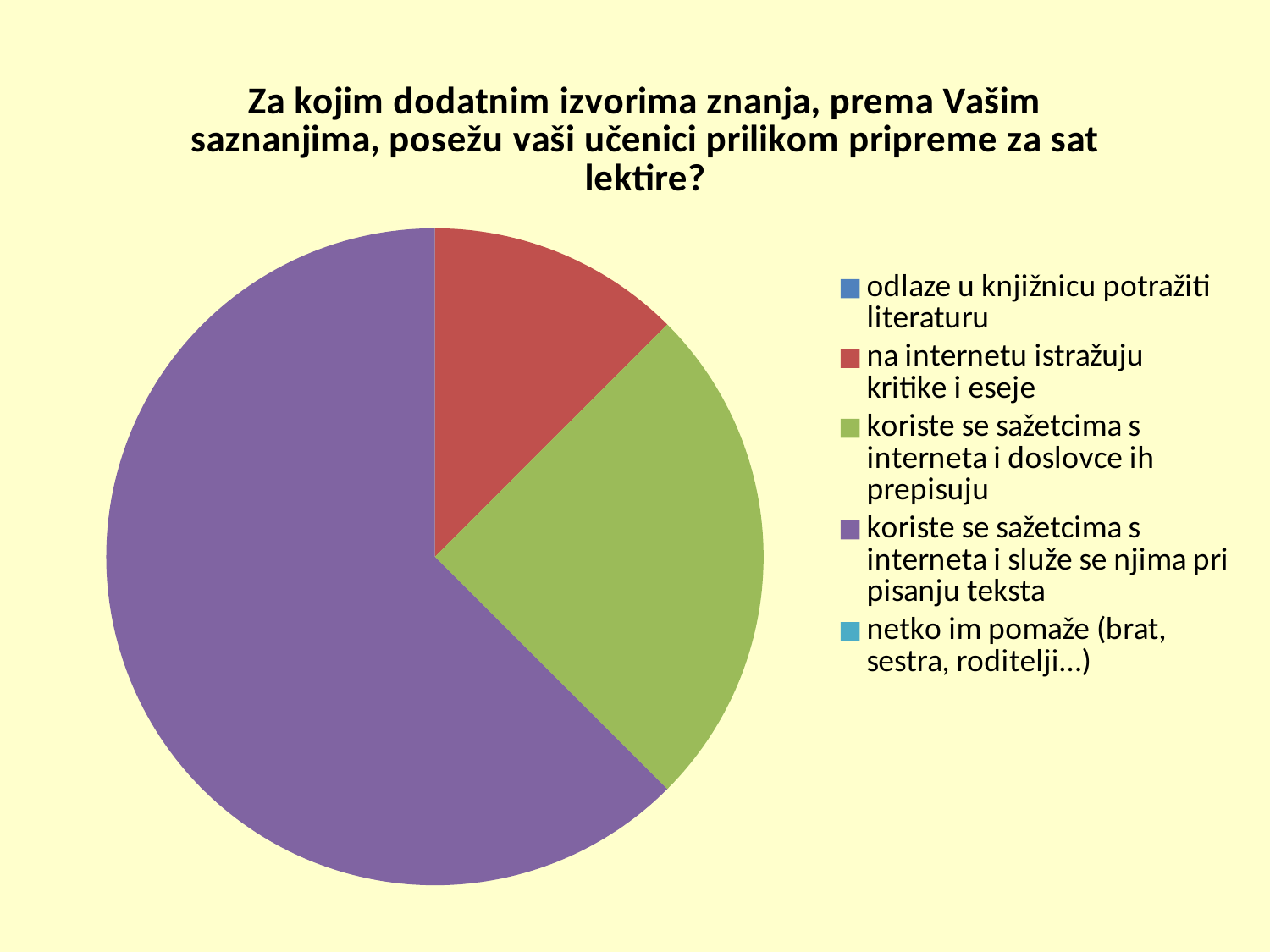
What kind of chart is shown on the slide? pie chart Is the share of the pie for 'na internetu istražuju kritike i eseje' greater or less than 25%? less How many entries does the legend list? 5 Which legend entry is shown in red? na internetu istražuju kritike i eseje Is the share of the pie for 'koriste se sažetcima s interneta i služe se njima pri pisanju teksta' greater or less than 50%? greater What colour is the largest slice of the pie? purple Which category has the largest slice of the pie? koriste se sažetcima s interneta i služe se njima pri pisanju teksta Which slice is larger: 'na internetu istražuju kritike i eseje' or 'koriste se sažetcima s interneta i doslovce ih prepisuju'? koriste se sažetcima s interneta i doslovce ih prepisuju Which slice is larger: 'koriste se sažetcima s interneta i doslovce ih prepisuju' or 'koriste se sažetcima s interneta i služe se njima pri pisanju teksta'? koriste se sažetcima s interneta i služe se njima pri pisanju teksta How many slices are visible in the pie? 3